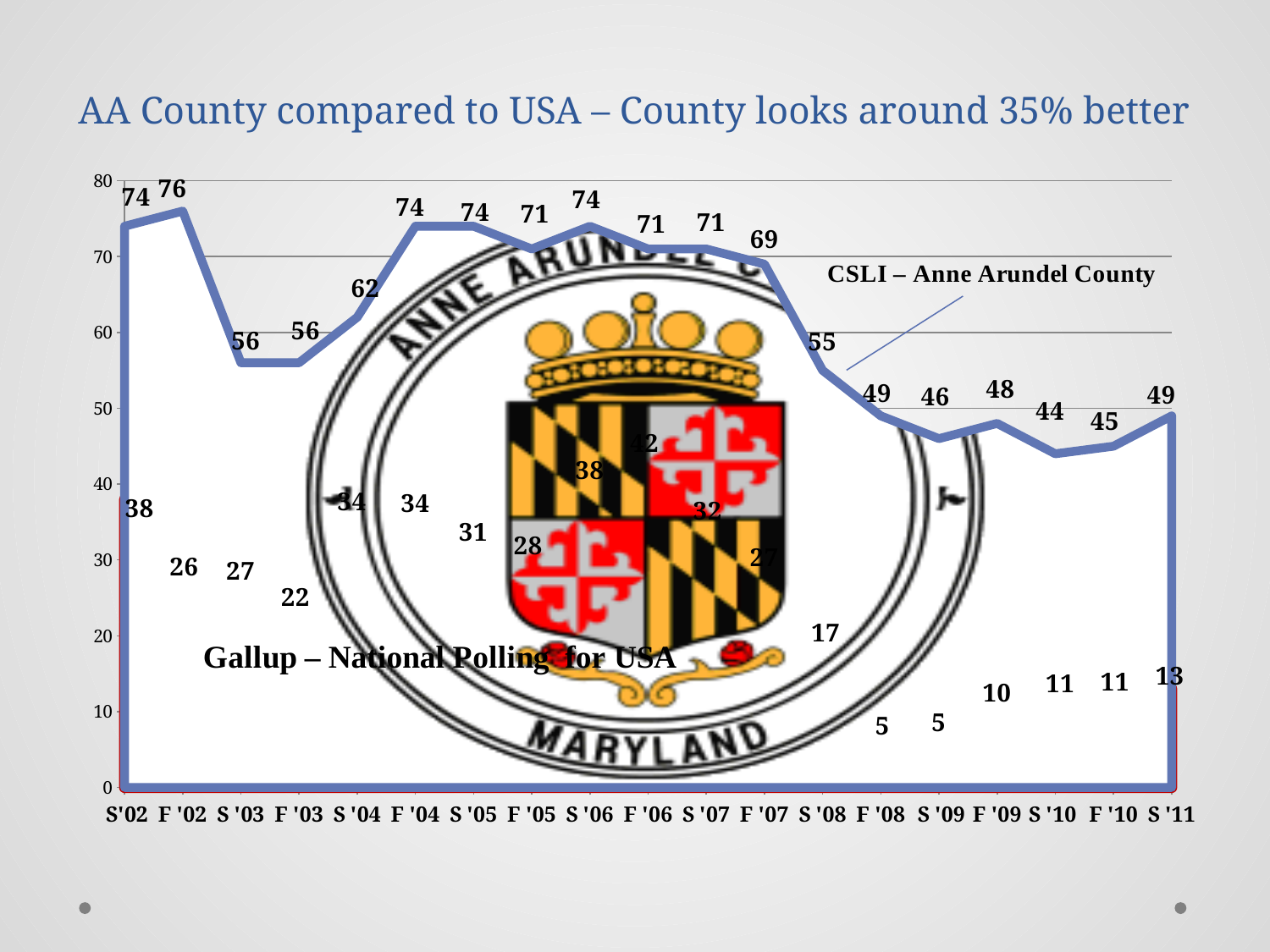
What is the Gallup – National Polling for USA value for S '08? 17 What is the CSLI – Anne Arundel County value for F '02? 76 What kind of chart is shown on the slide? Area chart By how much did the CSLI – Anne Arundel County value drop from F '02 to S '03? 20 In which period does the CSLI – Anne Arundel County series reach its highest value? F '02 Which is larger for CSLI – Anne Arundel County: the value in S '08 or the value in F '08? S '08 Does the CSLI – Anne Arundel County series rise or fall from S '07 to S '10? Fall What is the difference between the CSLI – Anne Arundel County value and the Gallup – National Polling for USA value in S '11? 36 In which period does the CSLI – Anne Arundel County series reach its lowest value? S '10 What is the title of the slide? AA County compared to USA – County looks around 35% better What is the CSLI – Anne Arundel County value for S '03? 56 How many periods are shown on the x axis? 19